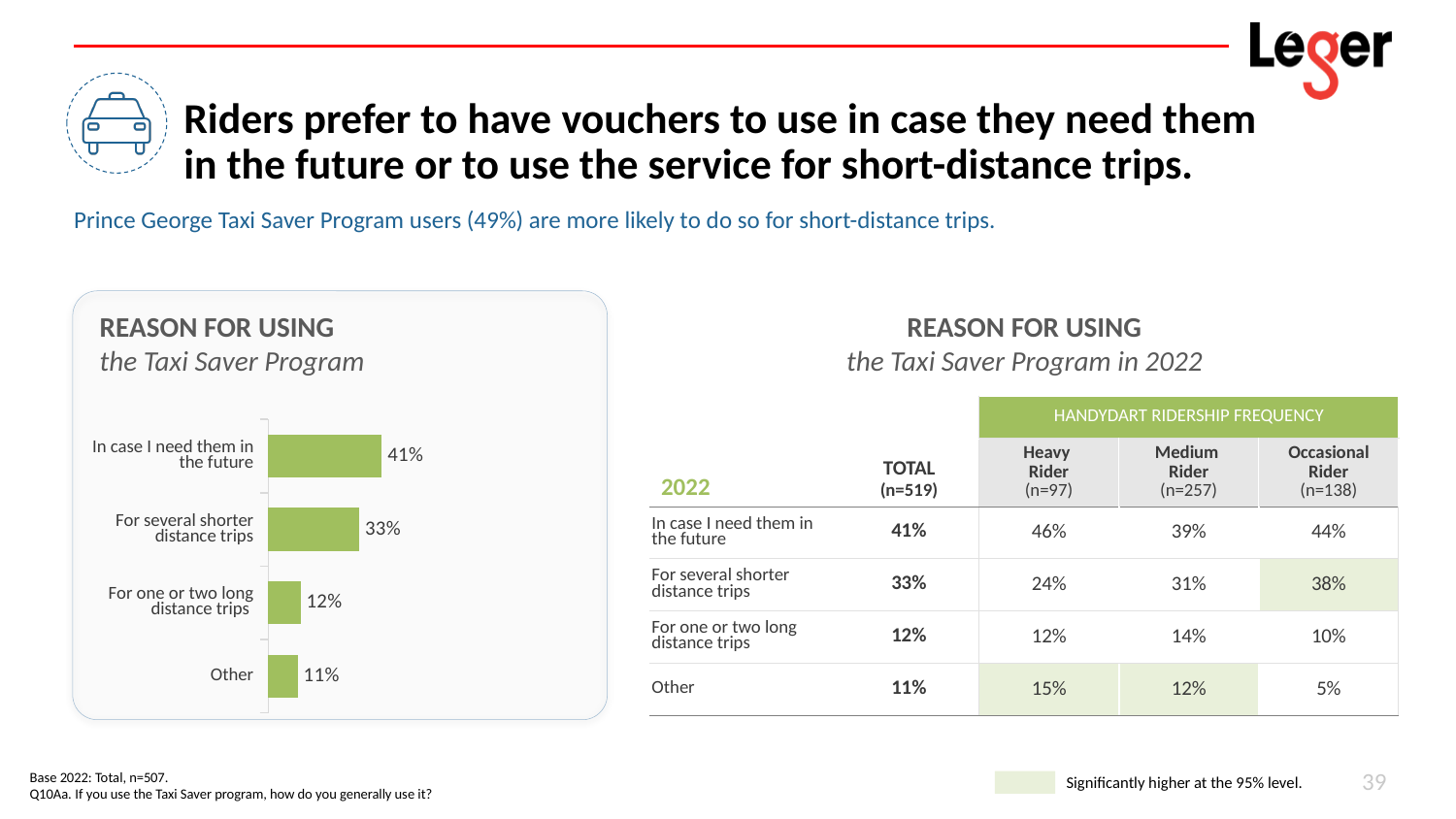
Which reason for using the Taxi Saver Program has the lowest percentage in the bar chart? Other What percentage of respondents use the Taxi Saver Program in case they need the vouchers in the future? 41% Which is larger in the bar chart: 'For one or two long distance trips' or 'Other'? For one or two long distance trips How many reason categories are shown in the bar chart? 4 What is the difference in percentage points between 'For several shorter distance trips' and 'For one or two long distance trips' in the bar chart? 21 What percentage of respondents selected 'Other' as their reason for using the Taxi Saver Program? 11% What percentage of respondents use the Taxi Saver Program for one or two long distance trips? 12% What percentage of respondents use the Taxi Saver Program for several shorter distance trips? 33% Which reason for using the Taxi Saver Program has the highest percentage in the bar chart? In case I need them in the future What is the difference in percentage points between 'In case I need them in the future' and 'For several shorter distance trips' in the bar chart? 8 What type of chart is used to show the reasons for using the Taxi Saver Program? Bar chart What is the title of the bar chart on the left of the slide? REASON FOR USING the Taxi Saver Program